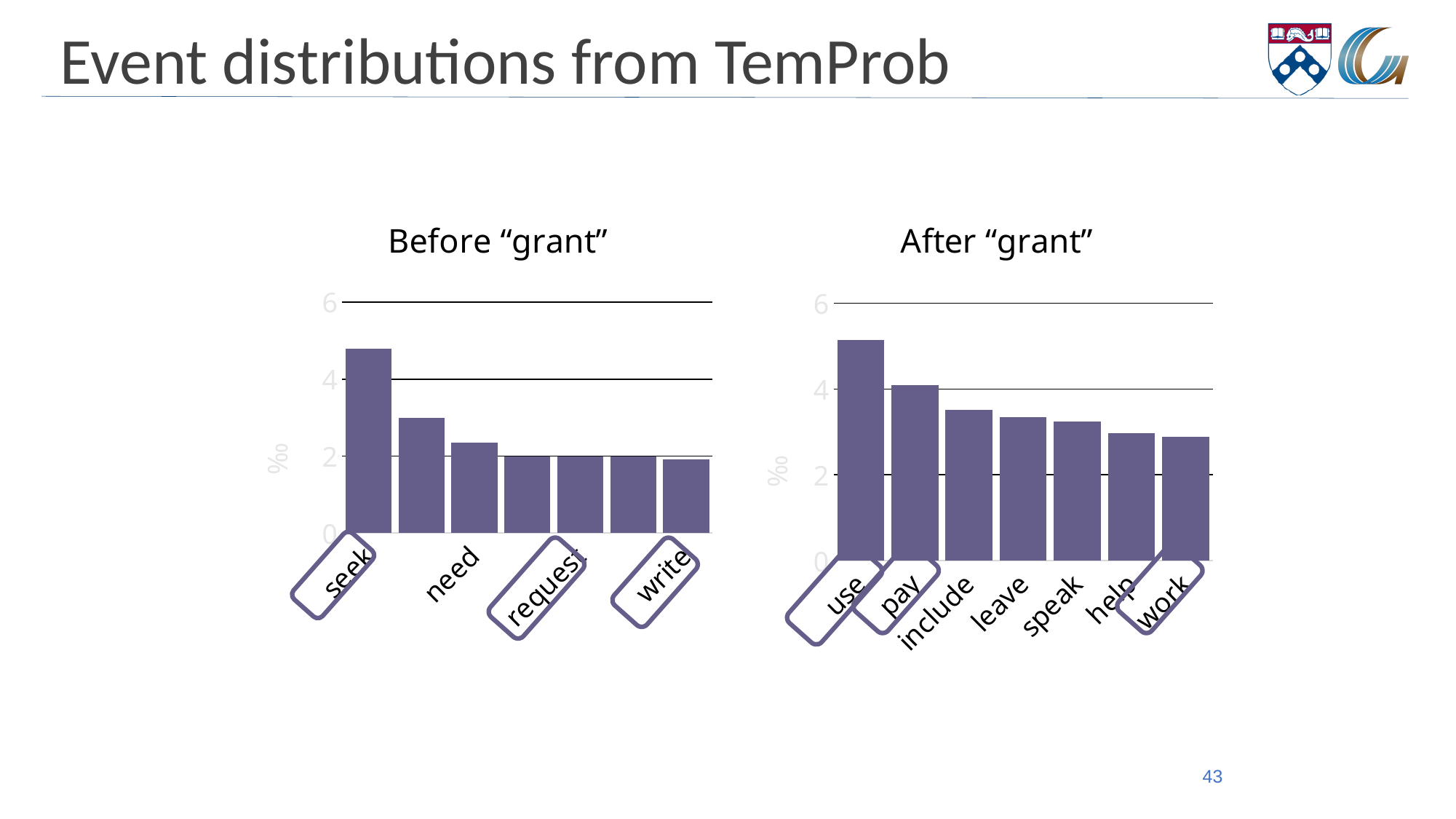
In the "Before "grant"" chart, which category has the highest value? seek In the "Before "grant"" chart, is the value for need greater or less than 4? less In the "After "grant"" chart, which is larger, the value for include or the value for help? include In the "Before "grant"" chart, which is larger, the value for seek or the value for need? seek What kind of chart is the "Before "grant"" chart? bar chart In the "After "grant"" chart, is the value for use greater or less than 4? greater In the "After "grant"" chart, which category has the highest value? use In the "After "grant"" chart, do the values rise or fall from left to right along the x axis? fall In the "Before "grant"" chart, is the value for seek greater or less than 4? greater How many bars are plotted in the "Before "grant"" chart? 7 What unit is shown on the y axis of the "After "grant"" chart? ‰